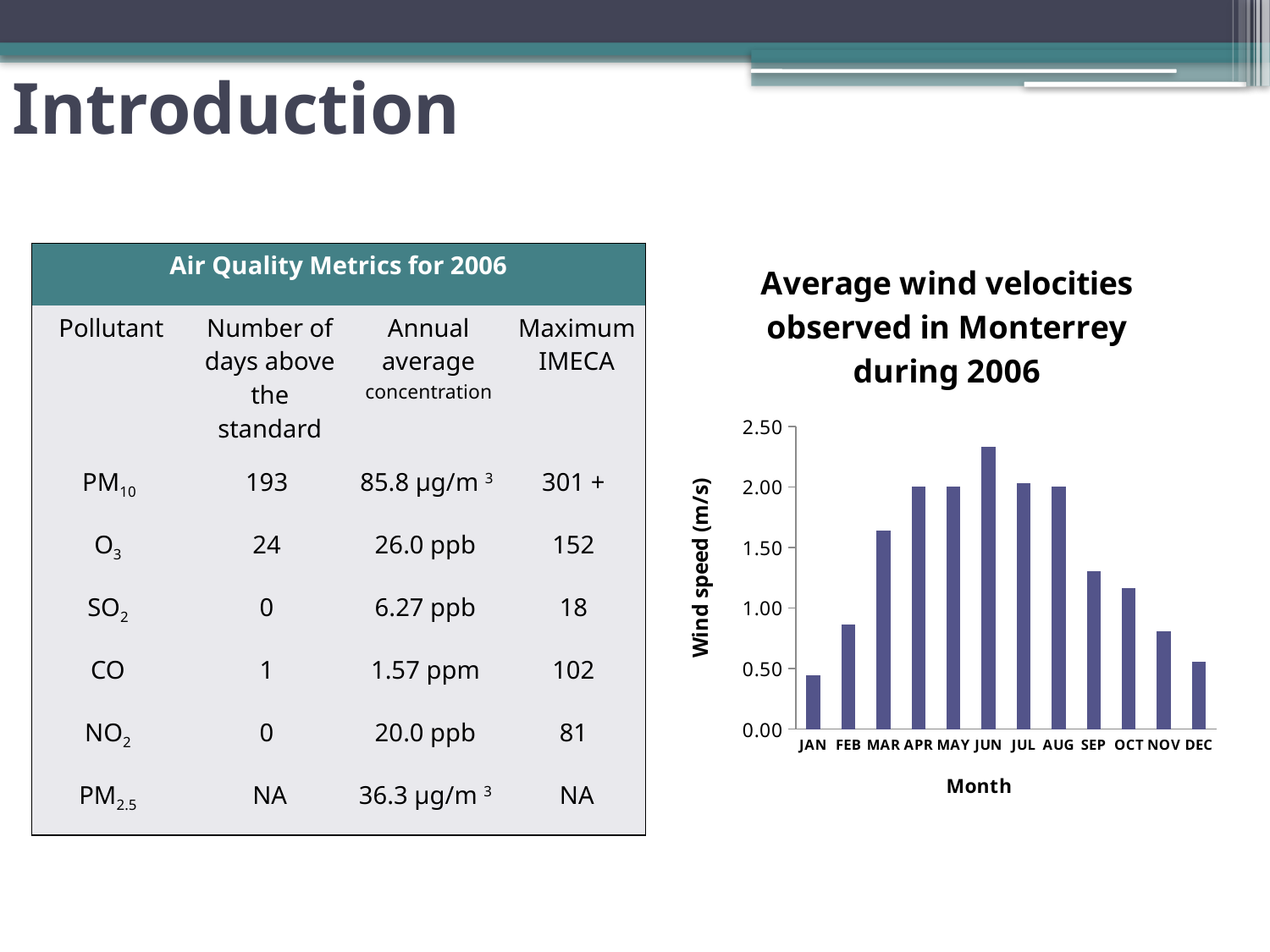
What kind of chart is used to show the average wind velocities observed in Monterrey during 2006? bar chart Is the average wind speed for MAR greater or less than 1.50 m/s? greater Is the average wind speed for SEP greater or less than 1.50 m/s? less What is the label on the vertical axis of the wind velocity chart? Wind speed (m/s) Is the average wind speed for JUN greater or less than 2.00 m/s? greater Which month has the lowest average wind speed on the chart? JAN Do the average wind speeds rise or fall from JAN to JUN? rise Which month has the highest average wind speed on the chart? JUN How many months are plotted on the wind velocity chart? 12 Which month has a higher average wind speed, JUN or DEC? JUN